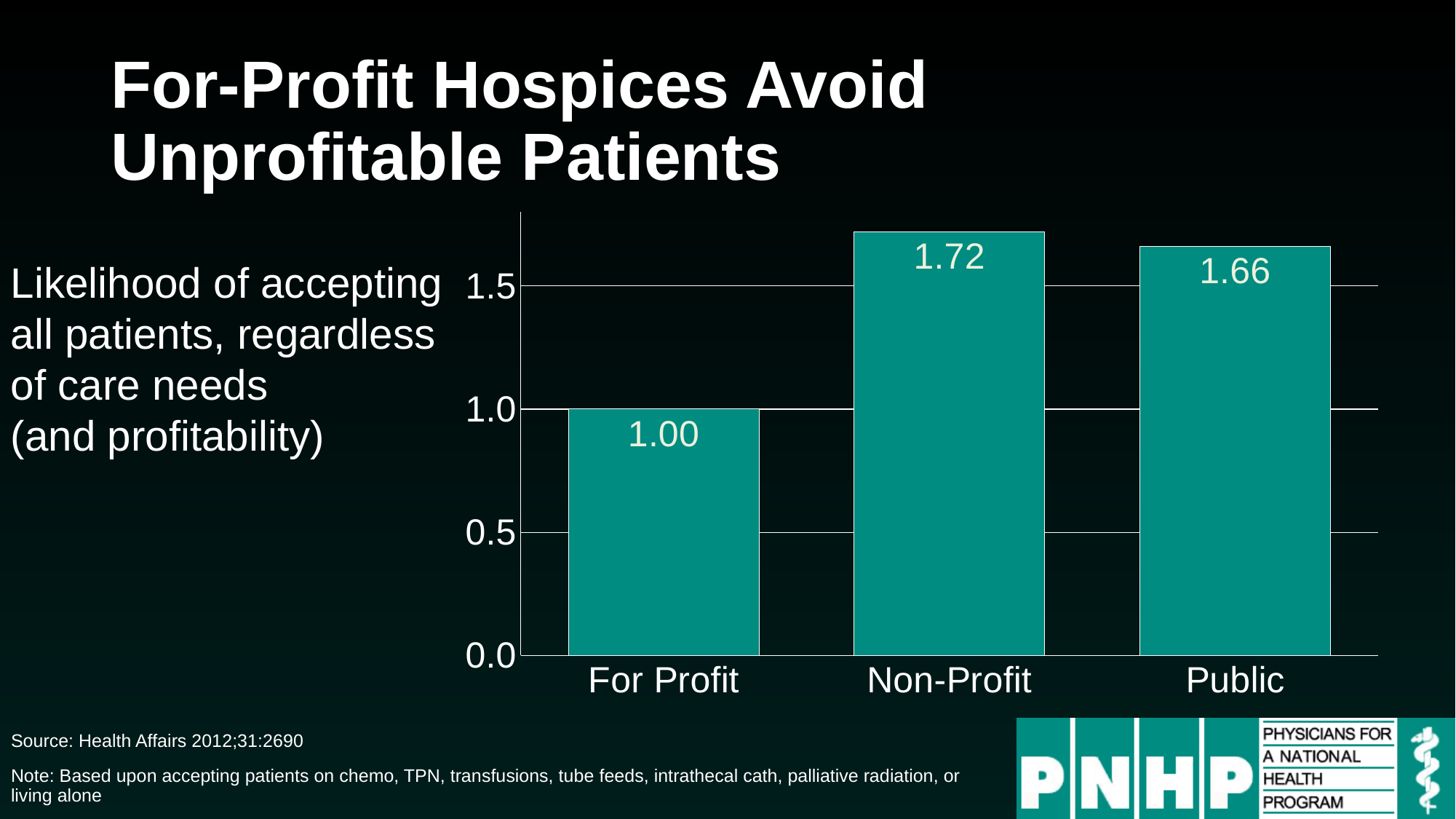
What is the value for Public? 1.66 How many categories are shown on the x axis? 3 What is the difference between the values for Non-Profit and For Profit? 0.72 Which category has the lowest value? For Profit Which is larger, the value for Public or the value for For Profit? Public What is the difference between the values for Non-Profit and Public? 0.06 What is the value for For Profit? 1.00 What kind of chart is shown on the slide? bar chart Is the value for Public greater or less than 1.5? greater What is the title of the slide containing the chart? For-Profit Hospices Avoid Unprofitable Patients What is the value for Non-Profit? 1.72 Which category has the highest value? Non-Profit